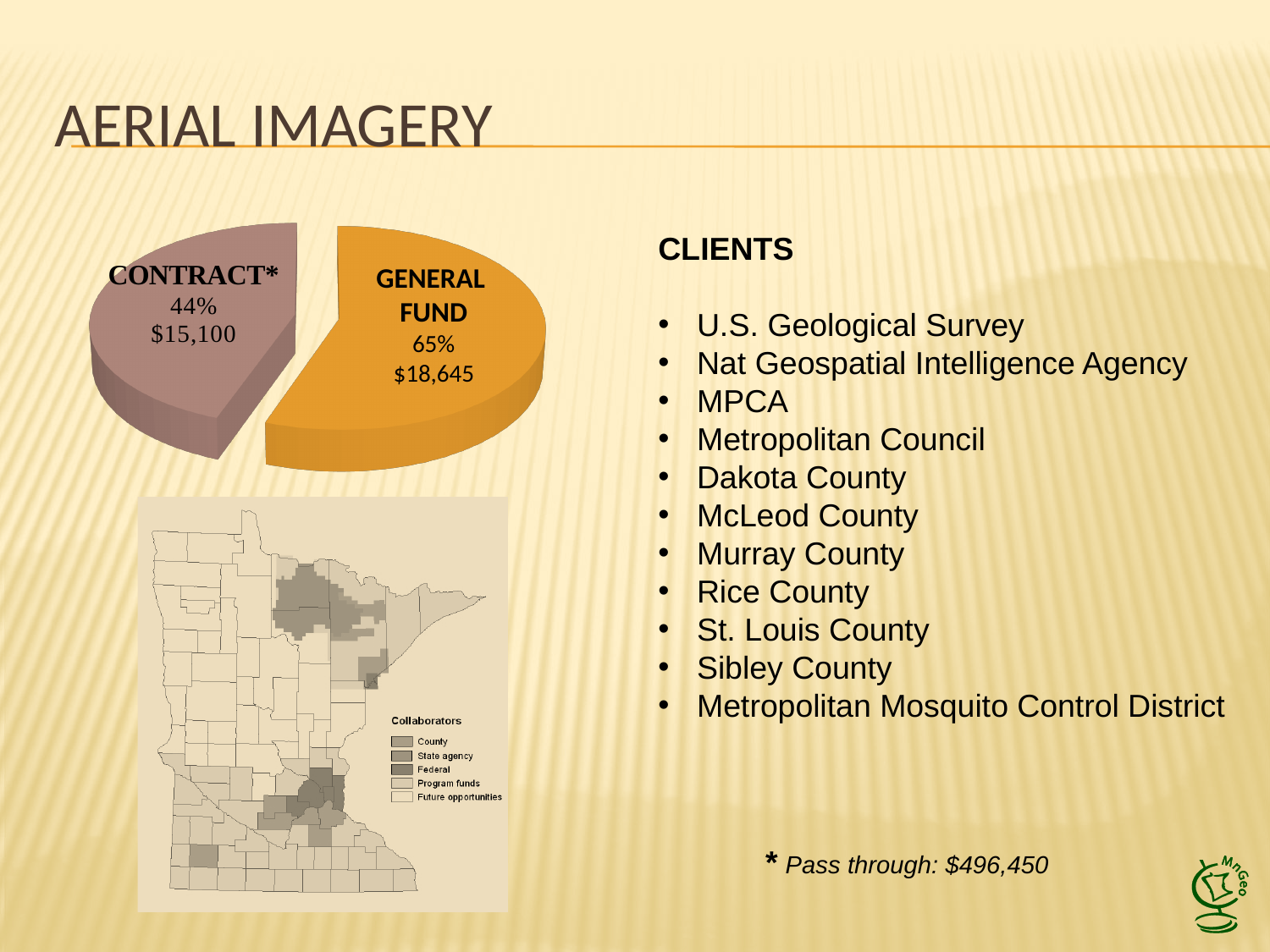
What percentage is shown for the CONTRACT* slice of the pie chart? 44% What dollar value is shown for the CONTRACT* slice of the pie chart? $15,100 What percentage is shown for the GENERAL FUND slice of the pie chart? 65% What is the difference in dollars between the GENERAL FUND slice and the CONTRACT* slice of the pie chart? $3,545 What dollar value is shown for the GENERAL FUND slice of the pie chart? $18,645 Which slice of the pie chart is the smallest? CONTRACT* How many slices does the pie chart have? 2 Which slice of the pie chart is the largest? GENERAL FUND What kind of chart is shown on the slide? pie chart What is the title of the slide containing the pie chart? AERIAL IMAGERY What is the combined dollar value of the two slices in the pie chart? $33,745 Which is larger in the pie chart, the CONTRACT* value or the GENERAL FUND value? GENERAL FUND